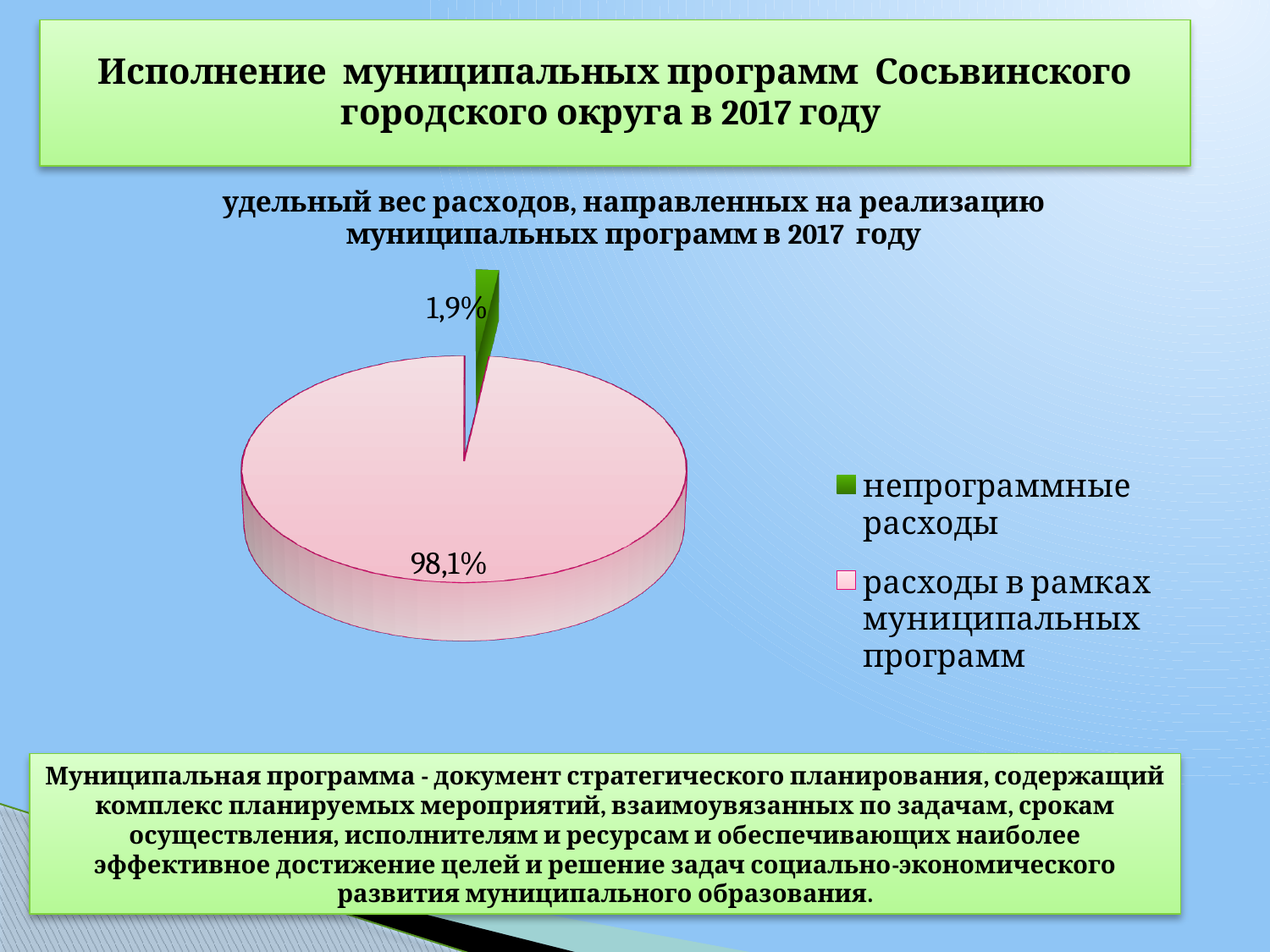
What is the title of the chart? удельный вес расходов, направленных на реализацию муниципальных программ в 2017 году Which category has the largest slice of the pie? расходы в рамках муниципальных программ What colour is the slice for 'непрограммные расходы'? green How many slices does the pie chart have? 2 Which is larger: the slice for 'непрограммные расходы' or the slice for 'расходы в рамках муниципальных программ'? расходы в рамках муниципальных программ What kind of chart is shown on the slide? pie chart What share of the pie is labelled for 'расходы в рамках муниципальных программ'? 98,1% How many entries does the legend list? 2 Which category has the smallest slice of the pie? непрограммные расходы What is the difference in percentage points between the two slices of the pie? 96,2 What share of the pie is labelled for 'непрограммные расходы'? 1,9%